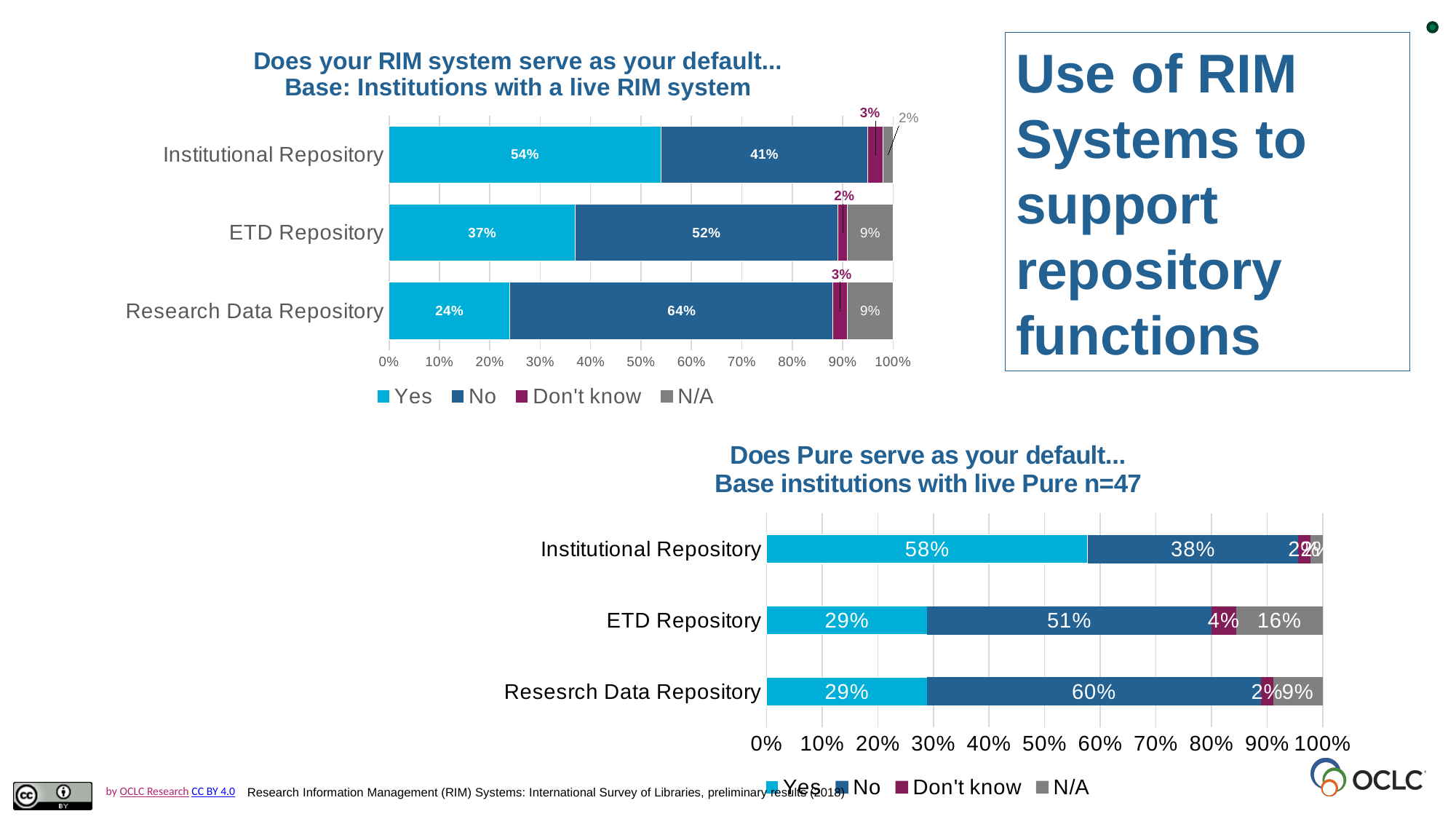
In the chart 'Does your RIM system serve as your default...', what is the difference between the No values for Research Data Repository and Institutional Repository? 23% In the chart 'Does your RIM system serve as your default...', what is the N/A value for ETD Repository? 9% How many series does the legend of the chart 'Does your RIM system serve as your default...' list? 4 In the chart 'Does Pure serve as your default...', what is the N/A value for ETD Repository? 16% In the chart 'Does Pure serve as your default...', which category has the lowest No value? Institutional Repository In the chart 'Does Pure serve as your default...', what is the Don't know value for ETD Repository? 4% In the chart 'Does your RIM system serve as your default...', which category has the highest Yes value? Institutional Repository In the chart 'Does your RIM system serve as your default...', what percentage answered Yes for Institutional Repository? 54% In the chart 'Does Pure serve as your default...', what percentage answered Yes for Institutional Repository? 58% What type of chart is 'Does Pure serve as your default...'? Stacked bar chart In the chart 'Does Pure serve as your default...', is the No value for Research Data Repository larger than the No value for ETD Repository? Yes In the chart 'Does your RIM system serve as your default...', what is the No value for Research Data Repository? 64%